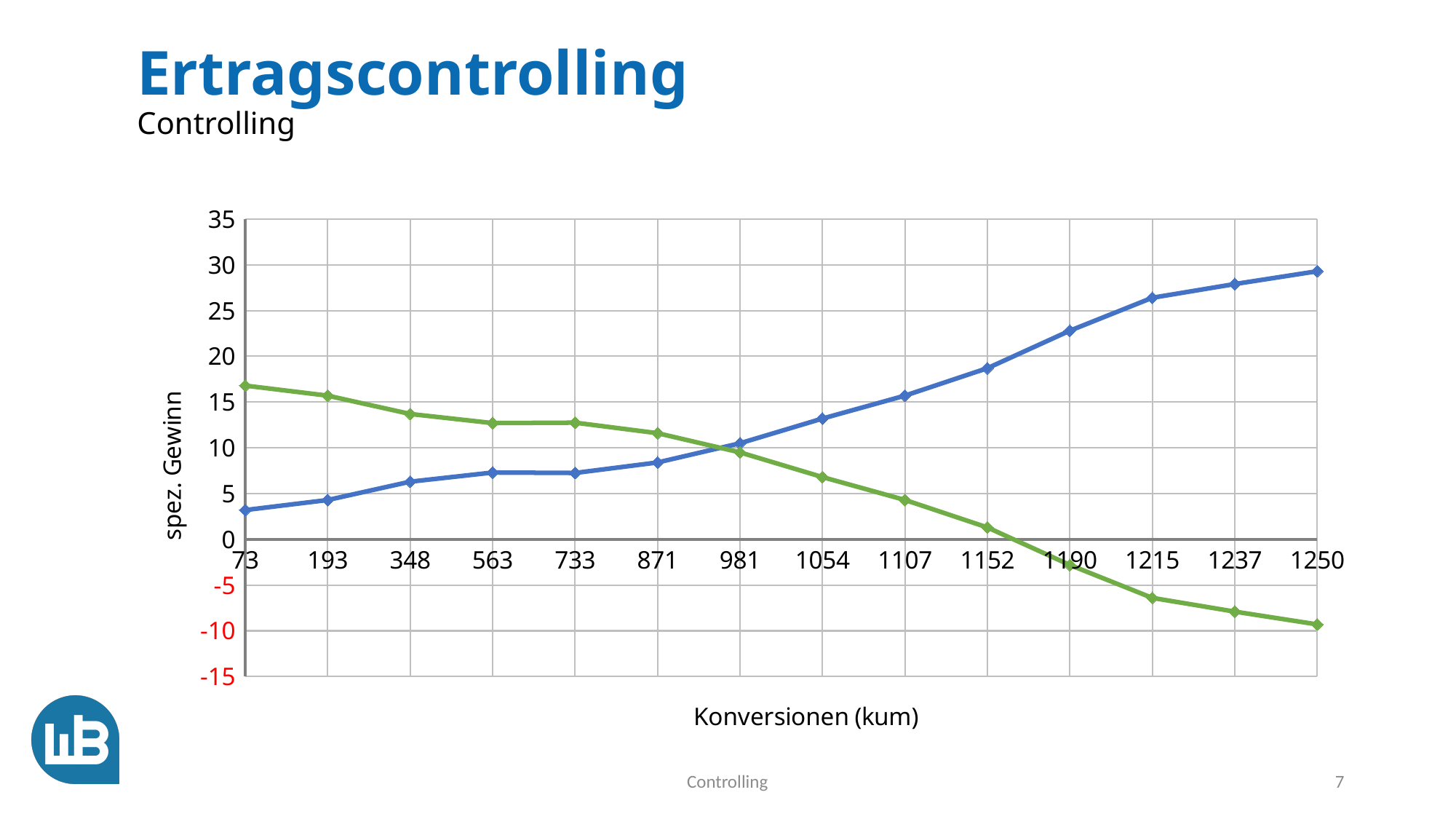
At 871 on the x axis, which line has the larger value, the blue line or the green line? green line How many lines are plotted in the chart? 2 Does the blue line rise or fall as Konversionen (kum) increases? rises How many points are plotted along the x axis (Konversionen (kum))? 14 At which x-axis value does the green line reach its lowest point? 1250 What is the title of the vertical axis? spez. Gewinn What kind of chart is shown on the slide? line chart Is the value of the green line at 1250 greater or less than -5? less Is the value of the green line at 73 greater or less than 15? greater Does the green line rise or fall as Konversionen (kum) increases? falls At which x-axis value does the blue line reach its highest point? 1250 Is the value of the blue line at 1250 greater or less than 25? greater